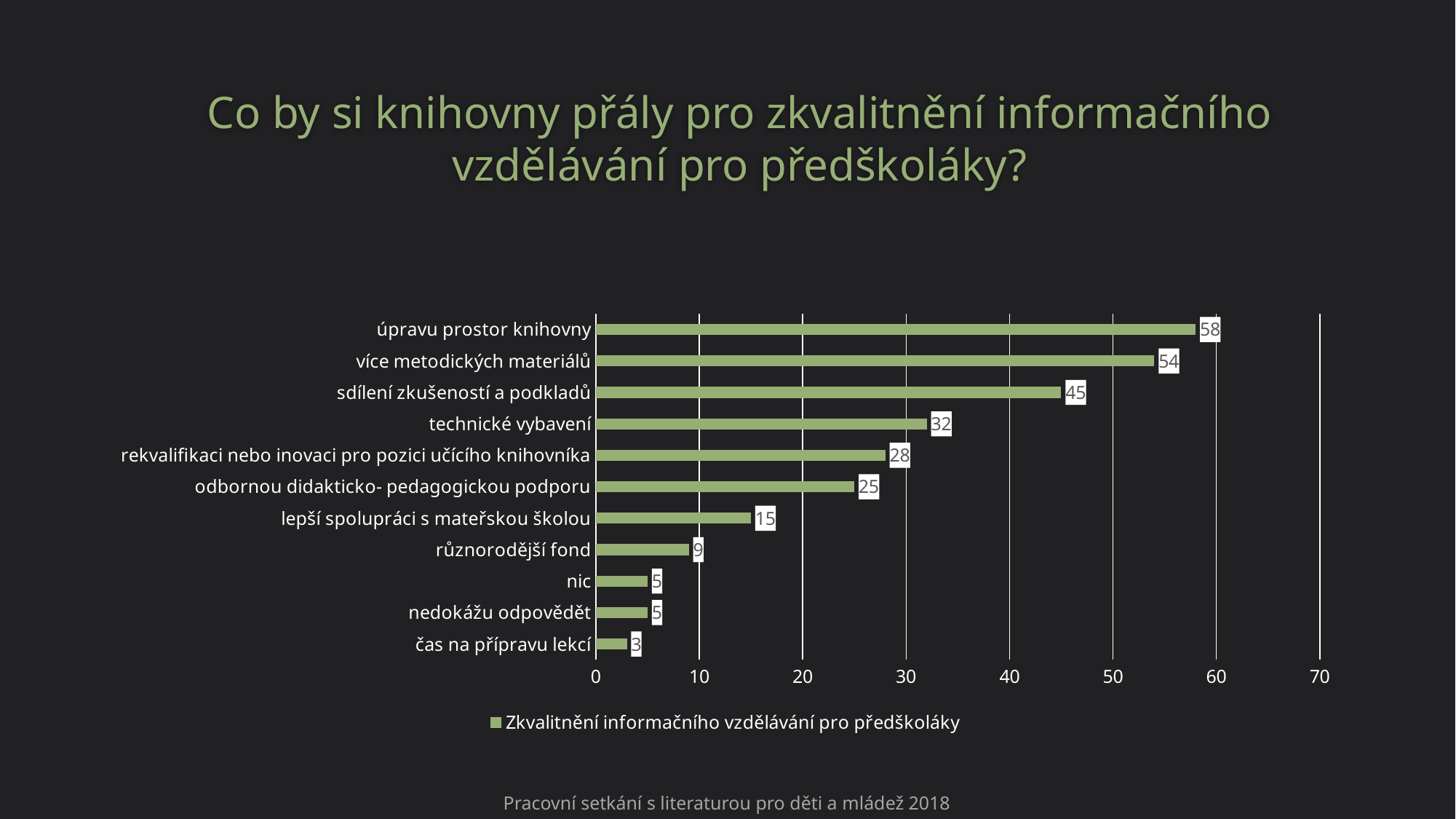
What is the value for "lepší spolupráci s mateřskou školou"? 15 How many series does the legend list? 1 What is the legend entry of the chart? Zkvalitnění informačního vzdělávání pro předškoláky What is the value for "technické vybavení"? 32 Is the value for "různorodější fond" greater or less than 10? less Which is larger, the value for "rekvalifikaci nebo inovaci pro pozici učícího knihovníka" or the value for "odbornou didakticko- pedagogickou podporu"? rekvalifikaci nebo inovaci pro pozici učícího knihovníka What kind of chart is shown on the slide? bar chart How many categories are shown in the chart? 11 Which category has the highest value? úpravu prostor knihovny What is the difference between the values for "více metodických materiálů" and "sdílení zkušeností a podkladů"? 9 What is the value for "úpravu prostor knihovny"? 58 Which category has the lowest value? čas na přípravu lekcí